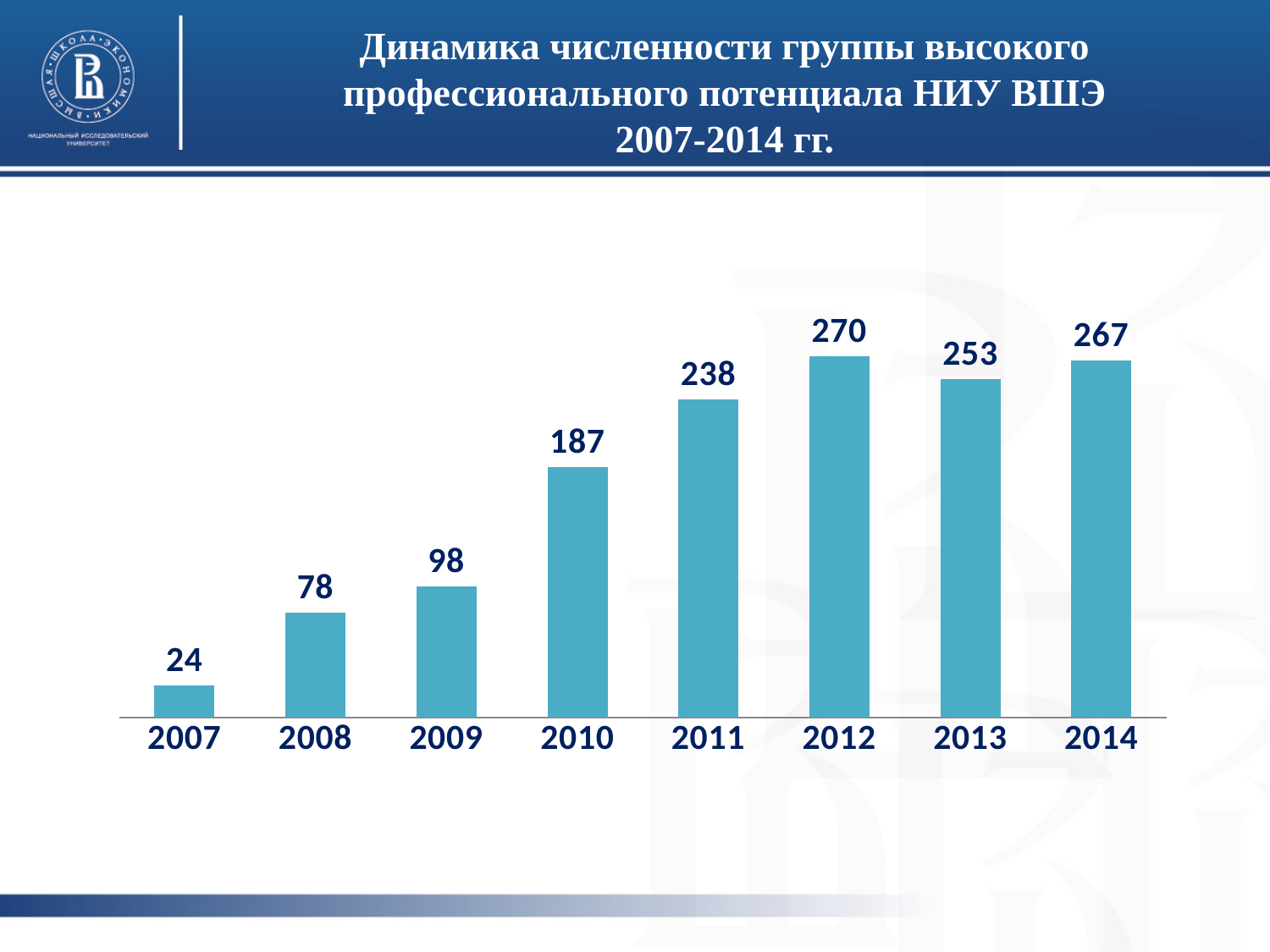
What is the difference between the values for 2012 and 2013? 17 Which is larger, the value for 2013 or the value for 2014? 2014 Which year has the highest value? 2012 What colour are the bars in the chart? blue How many years are shown on the x axis? 8 What is the value for 2011? 238 What is the difference between the values for 2010 and 2009? 89 Which year has the lowest value? 2007 Do the values generally rise or fall from 2007 to 2012? rise What is the value for 2007? 24 What kind of chart is shown on the slide? bar chart What is the value for 2014? 267